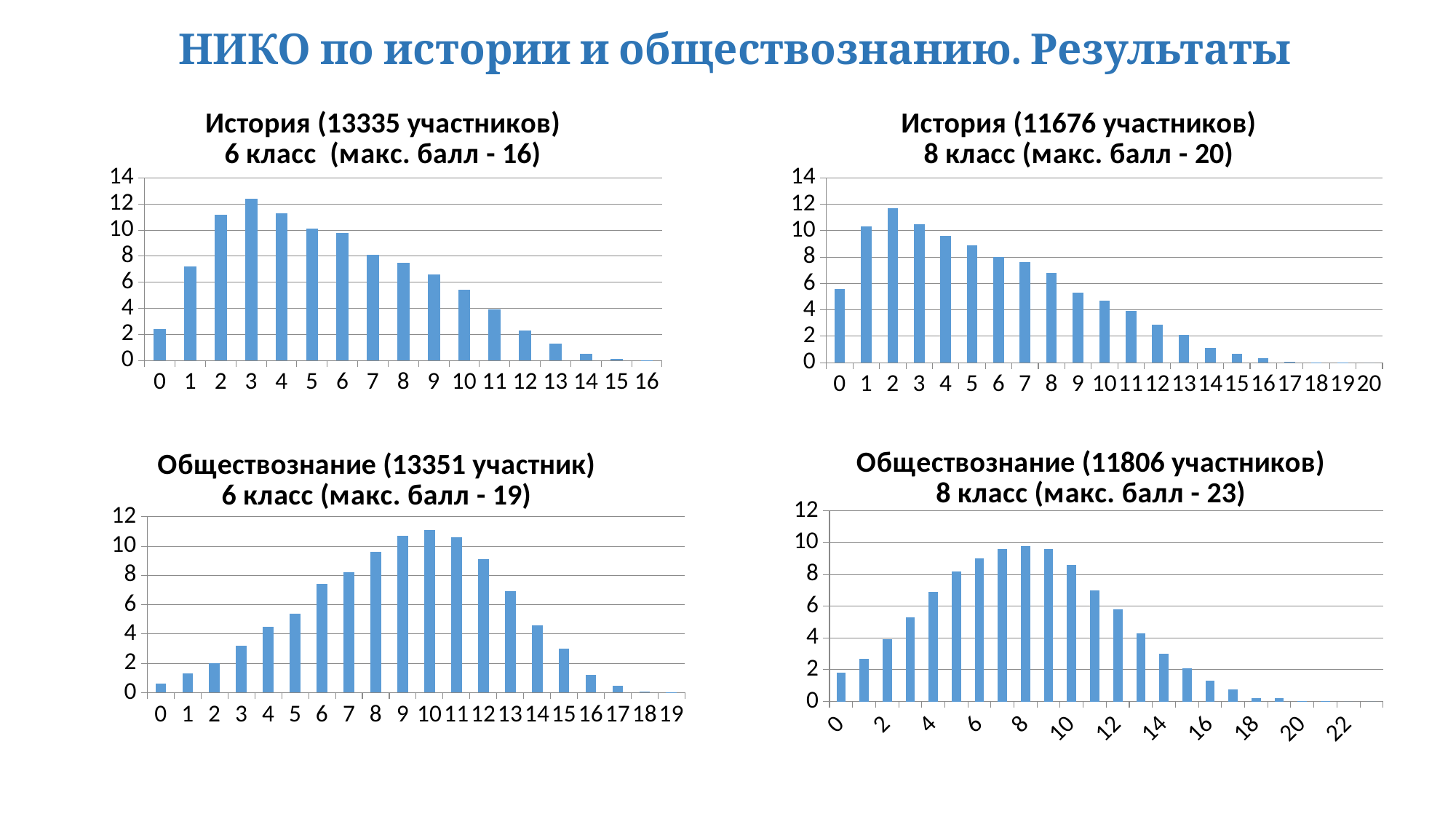
In the chart 'История (13335 участников) 6 класс', is the value for score 2 greater or less than 10? greater What kind of chart is used for 'Обществознание (11806 участников) 8 класс'? bar chart In the chart 'Обществознание (13351 участник) 6 класс', is the value for score 16 greater or less than 2? less In the chart 'Обществознание (11806 участников) 8 класс', is the value for score 10 greater or less than 8? greater In the chart 'Обществознание (13351 участник) 6 класс', which score has the highest bar? 10 In the chart 'История (13335 участников) 6 класс', which is larger: the value for score 1 or the value for score 2? score 2 In the chart 'История (11676 участников) 8 класс', which score has the highest bar? 2 How many score categories are shown on the x axis of the chart 'История (13335 участников) 6 класс'? 17 In the chart 'История (13335 участников) 6 класс', which score has the highest bar? 3 In the chart 'История (11676 участников) 8 класс', which is larger: the value for score 5 or the value for score 10? score 5 In the chart 'История (11676 участников) 8 класс', do the values rise or fall from score 2 to score 20? fall